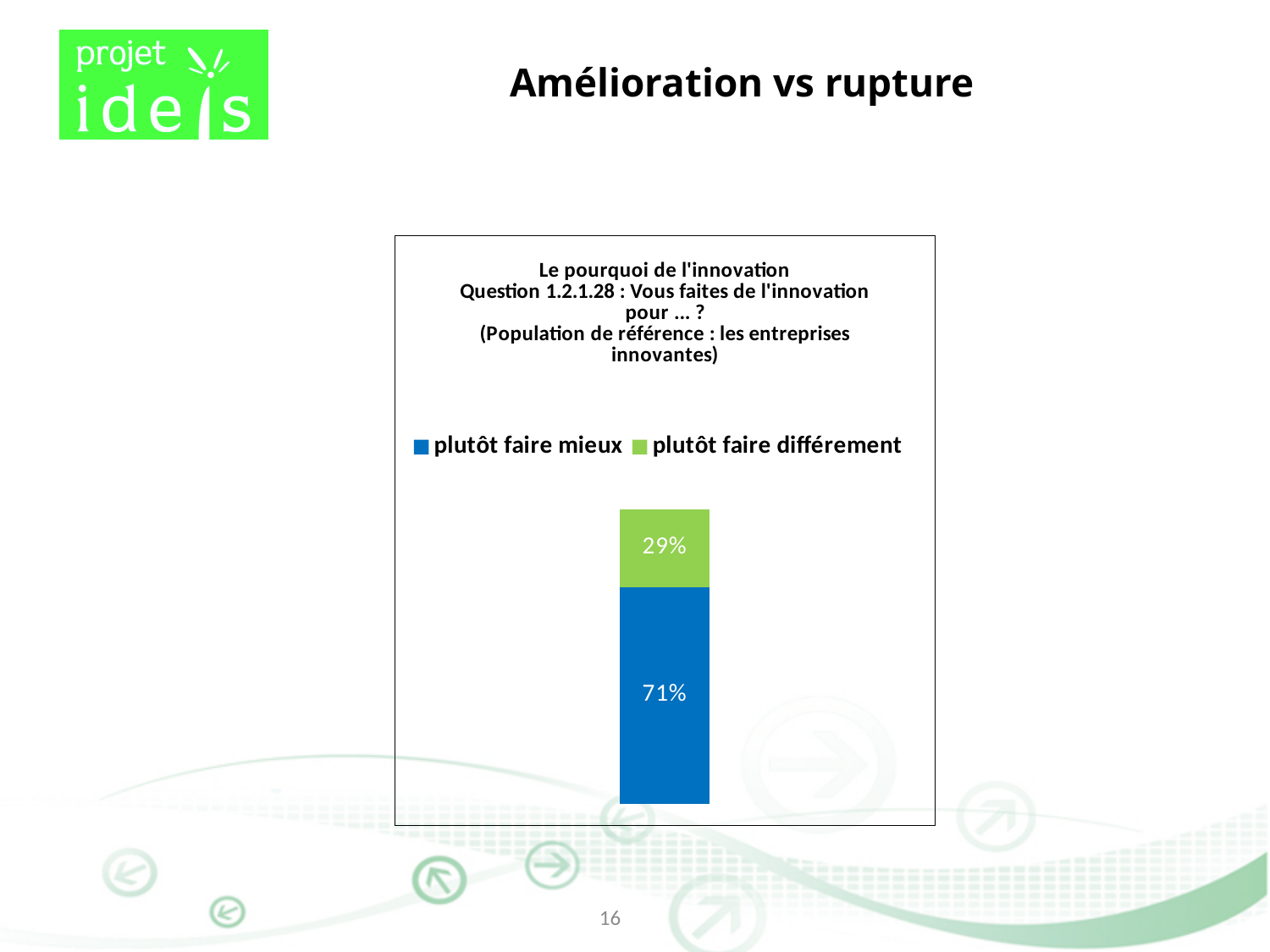
What is the total of the stacked bar? 100% Which series has the smallest value? plutôt faire différement How many series does the legend list? 2 What is the first line of the chart title? Le pourquoi de l'innovation How many bars are plotted in the chart? 1 What is the difference between the values for "plutôt faire mieux" and "plutôt faire différement"? 42% What is the value for "plutôt faire différement"? 29% What is the value for "plutôt faire mieux"? 71% What kind of chart is shown on the slide? stacked bar chart Which colour represents "plutôt faire mieux" in the chart? blue Which series has the larger value, "plutôt faire mieux" or "plutôt faire différement"? plutôt faire mieux